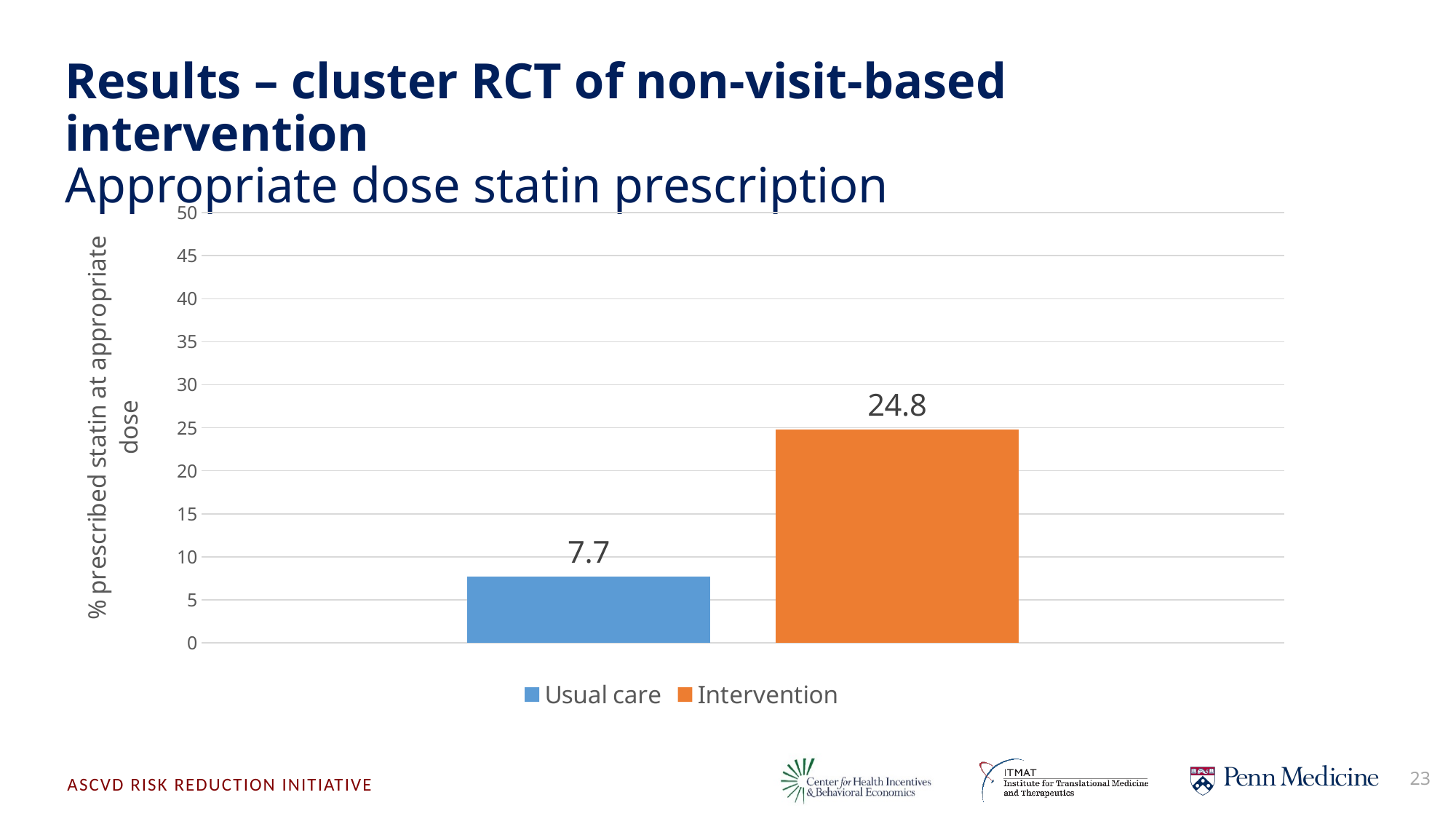
Is the value for Intervention greater or less than 20? greater Which group has the higher value, Usual care or Intervention? Intervention What is the value for Intervention? 24.8 How many series does the legend list? 2 What is the label on the vertical axis of the chart? % prescribed statin at appropriate dose Which group has the highest value? Intervention How many bars are plotted in the chart? 2 Is the value for Usual care greater or less than 10? less Which group has the lowest value? Usual care What kind of chart is shown on the slide? Bar chart What is the value for Usual care? 7.7 What is the difference between the Intervention and Usual care values? 17.1